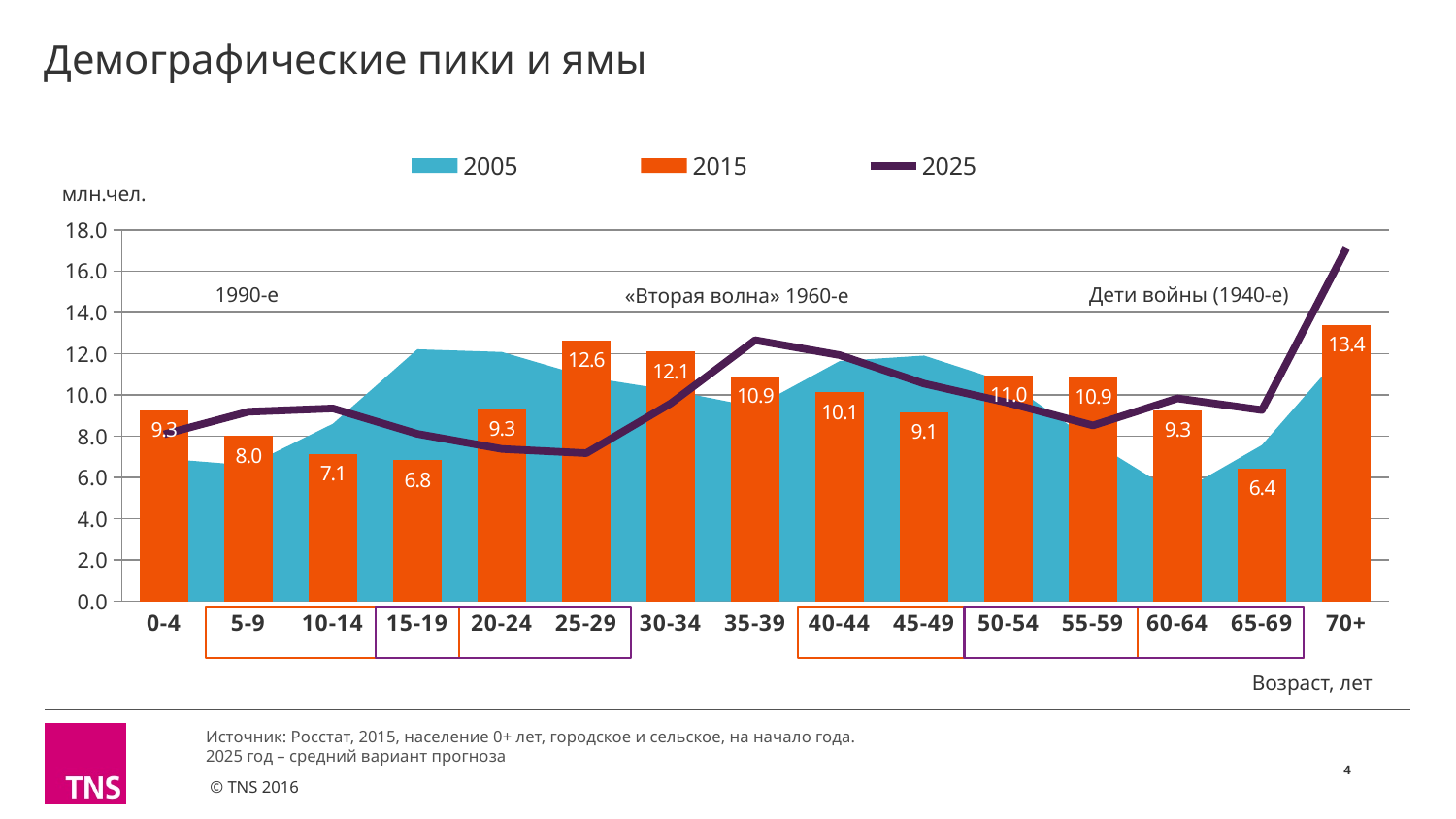
What kind of chart is used to show the 2015 series? bar chart How many series does the legend list? 3 What is the 2015 value for the 65-69 age group? 6.4 How many age groups are shown on the x axis? 15 Which has the larger 2015 value, the 30-34 age group or the 40-44 age group? 30-34 Which age group has the lowest 2015 value? 65-69 What is the 2015 value for the 45-49 age group? 9.1 What is the difference between the 2015 values for the 25-29 and 15-19 age groups? 5.8 Is the 2025 value for the 70+ age group greater or less than 16.0? greater Which age group has the highest 2015 value? 70+ What is the 2015 value for the 25-29 age group? 12.6 Do the 2015 values rise or fall from the 0-4 age group to the 15-19 age group? fall